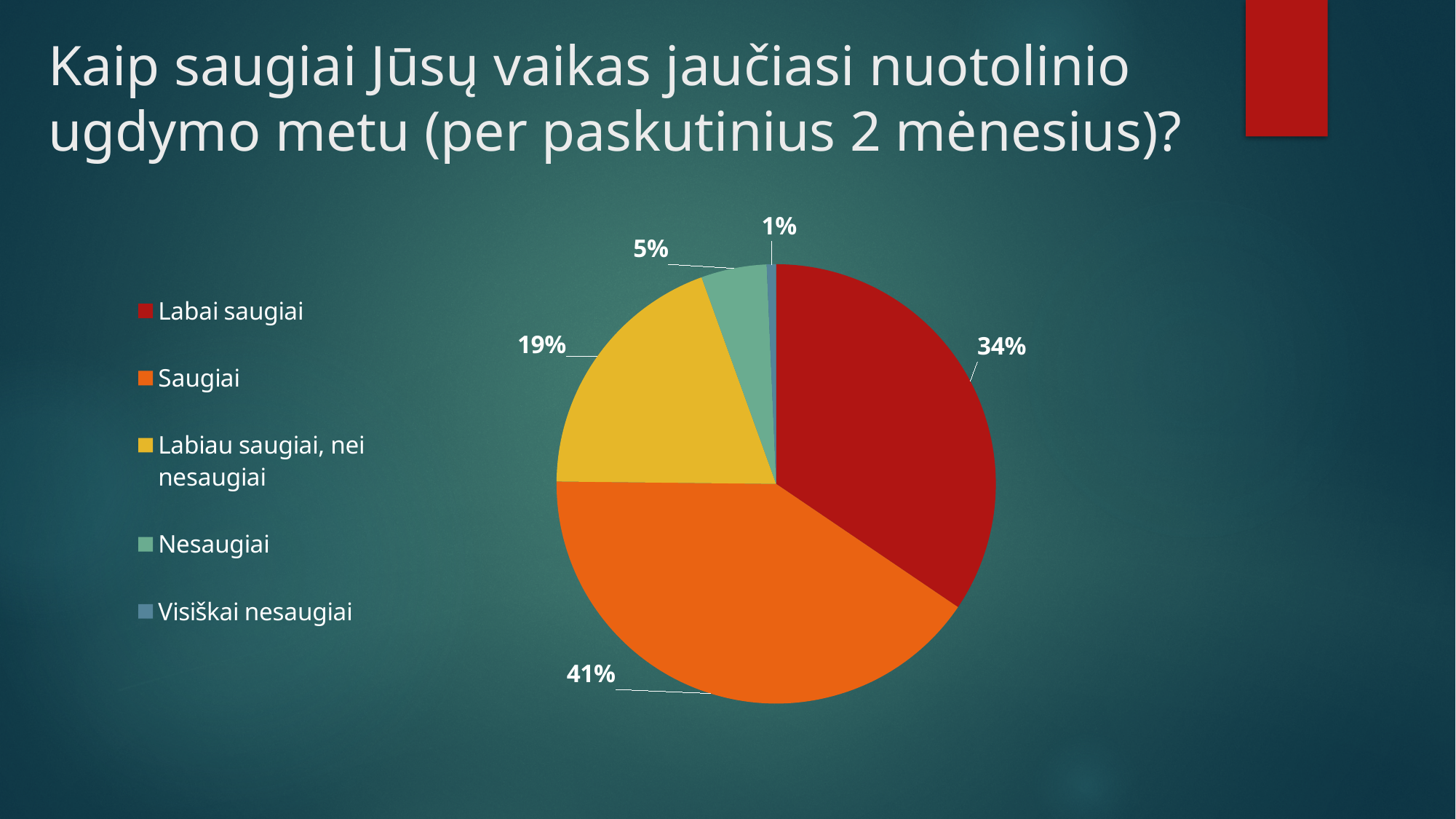
What share of the pie does "Saugiai" have? 41% Which category has the largest slice of the pie? Saugiai Which category has the smallest slice of the pie? Visiškai nesaugiai How many categories does the pie chart have? 5 Which is larger, the share for "Labiau saugiai, nei nesaugiai" or the share for "Nesaugiai"? Labiau saugiai, nei nesaugiai What share of the pie does "Labai saugiai" have? 34% What is the difference between the shares for "Saugiai" and "Labai saugiai"? 7% What share of the pie does "Nesaugiai" have? 5% What kind of chart is shown on the slide? pie chart What colour is the slice for "Labiau saugiai, nei nesaugiai"? yellow